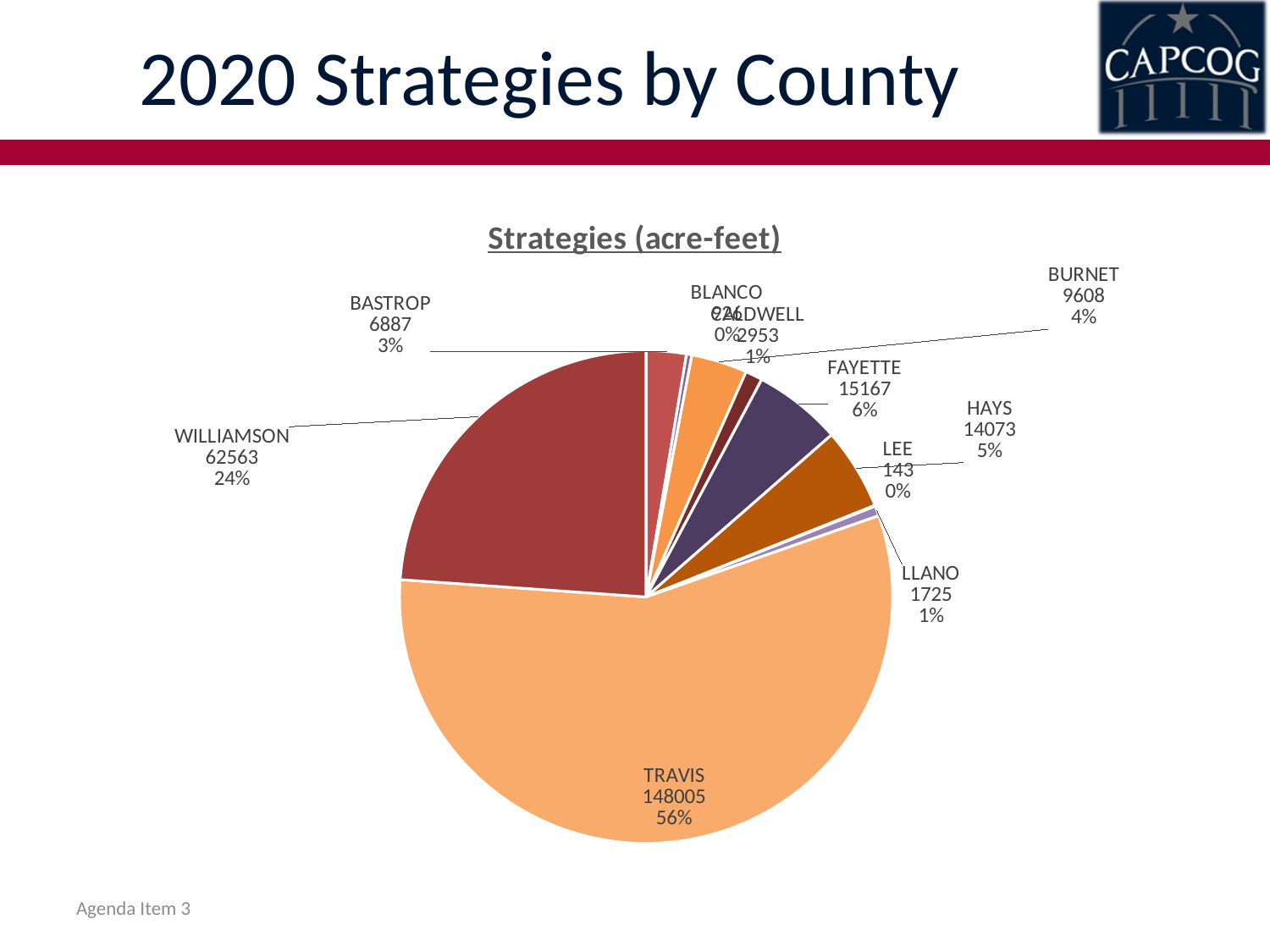
What is the difference between the values for TRAVIS and WILLIAMSON? 85442 What is the title of the chart? Strategies (acre-feet) What is the value for FAYETTE? 15167 What is the value for WILLIAMSON? 62563 Which county has the largest slice of the pie? TRAVIS What is the value for HAYS? 14073 How many counties are shown in the pie chart? 10 What kind of chart is shown on the slide? pie chart What is the value for TRAVIS? 148005 What share of the pie does BURNET represent? 4% Which is larger, the value for FAYETTE or the value for HAYS? FAYETTE What share of the pie does WILLIAMSON represent? 24%